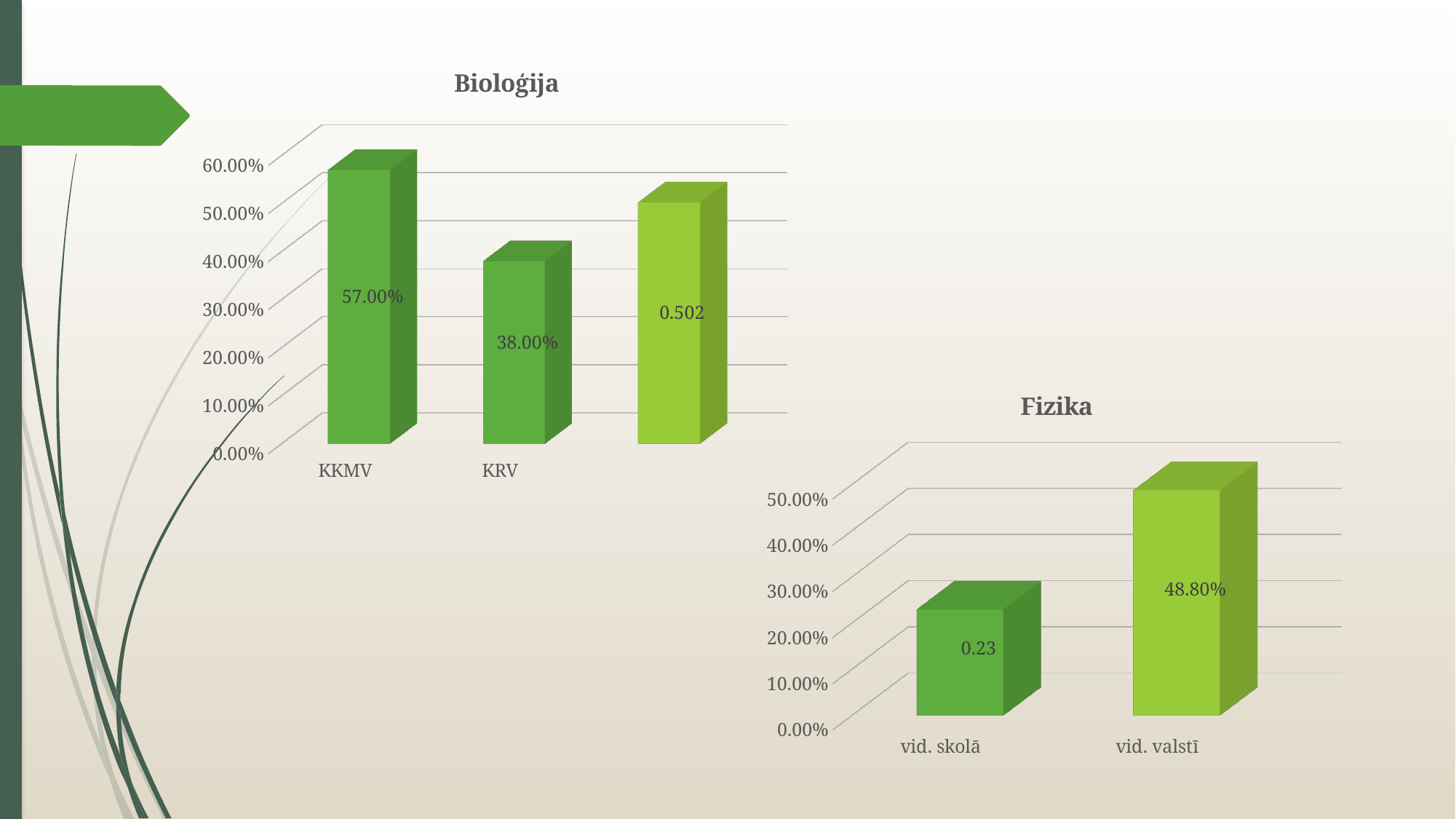
In the Bioloģija chart, which category has the lowest value? KRV In the Bioloģija chart, what is the value for KKMV? 57.00% In the Fizika chart, which category has the higher value, vid. skolā or vid. valstī? vid. valstī In the Bioloģija chart, what is the difference between the values for KKMV and KRV? 19.00% In the Fizika chart, what is the value for vid. valstī? 48.80% In the Fizika chart, is the value for vid. skolā greater or less than 30.00%? less In the Bioloģija chart, how many bars are plotted? 3 In the Bioloģija chart, what is the value for KRV? 38.00% What kind of chart is the Fizika chart? bar chart In the Fizika chart, what is the value for vid. skolā? 0.23 In the Bioloģija chart, which category has the highest value? KKMV In the Fizika chart, how many categories are shown on the x axis? 2